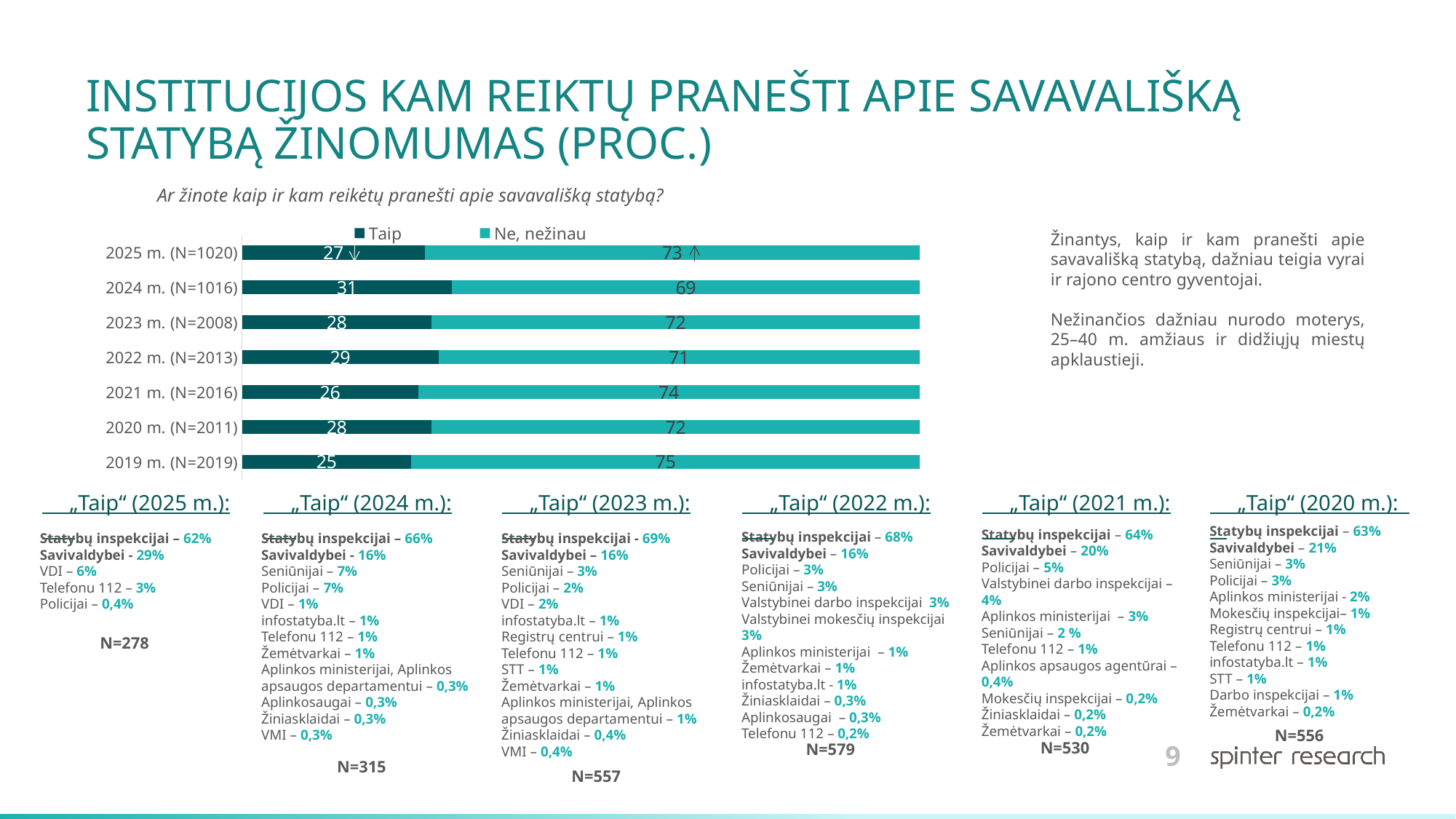
What are the two legend entries of the chart? Taip; Ne, nežinau What kind of chart is shown on the slide? Stacked bar chart What is the value for "Ne, nežinau" in 2019 m. (N=2019)? 75 What is the value for "Taip" in 2025 m. (N=1020)? 27 How many series does the legend list? 2 Which year has the highest "Taip" value? 2024 m. (N=1016) What is the value for "Taip" in 2024 m. (N=1016)? 31 What is the difference between the "Ne, nežinau" values for 2021 m. (N=2016) and 2024 m. (N=1016)? 5 Which is larger: the "Taip" value for 2022 m. (N=2013) or for 2021 m. (N=2016)? 2022 m. (N=2013) What is the total of the stacked bar for 2023 m. (N=2008)? 100 Which year has the lowest "Taip" value? 2019 m. (N=2019) How many years (categories) are shown in the chart? 7